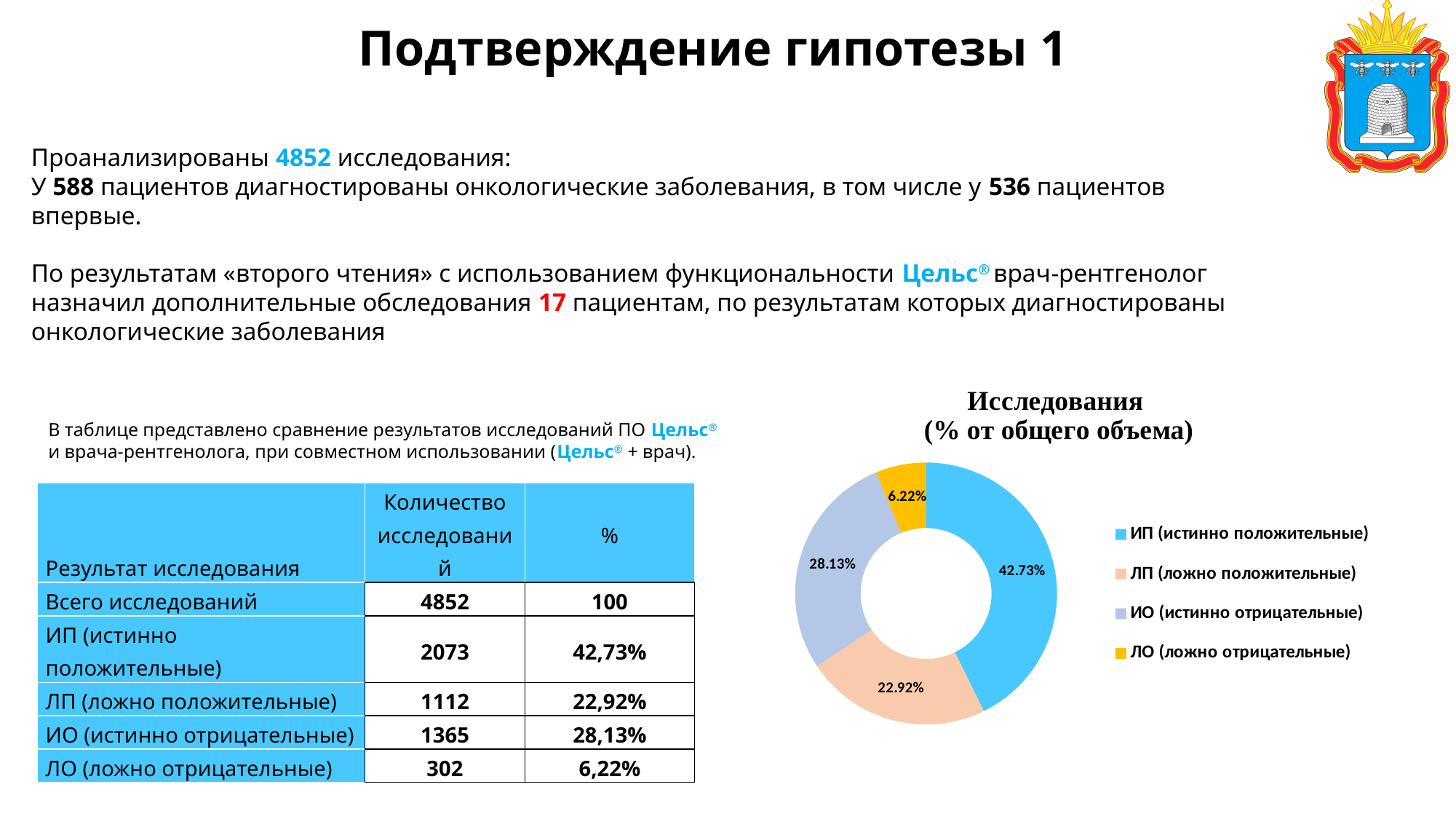
What type of chart is shown on the slide? Pie chart (donut) What share of the pie chart is labelled for ЛП (ложно положительные)? 22.92% Which category has the largest slice in the pie chart? ИП (истинно положительные) What share of the pie chart is labelled for ИП (истинно положительные)? 42.73% What share of the pie chart is labelled for ИО (истинно отрицательные)? 28.13% How many slices does the pie chart have? 4 Which category has the smallest slice in the pie chart? ЛО (ложно отрицательные) Which slice is larger in the pie chart: ЛП (ложно положительные) or ИО (истинно отрицательные)? ИО (истинно отрицательные) What colour is the slice for ЛО (ложно отрицательные) in the pie chart? Yellow What share of the pie chart is labelled for ЛО (ложно отрицательные)? 6.22% What is the title of the chart? Исследования (% от общего объема) How many entries does the chart legend list? 4